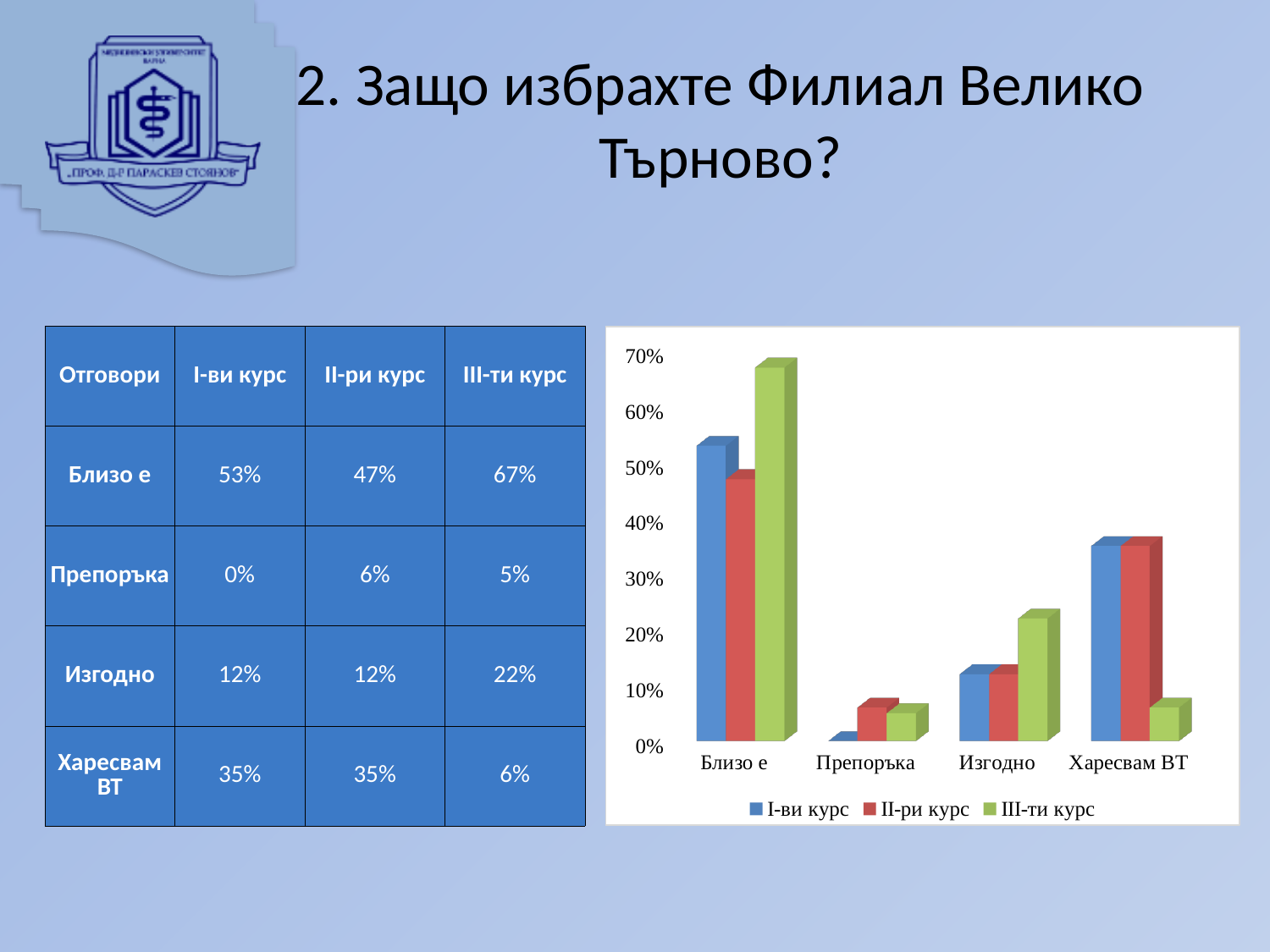
According to the slide, what is the value for III-ти курс in the category Близо е? 67% Which category has the highest value for III-ти курс? Близо е Which category has the lowest value for I-ви курс? Препоръка According to the slide, what is the value for I-ви курс in the category Харесвам ВТ? 35% How many categories are shown on the x axis of the chart? 4 According to the slide, what is the value for II-ри курс in the category Препоръка? 6% What is the difference between the III-ти курс and I-ви курс values in the category Изгодно? 10% Is the value for I-ви курс in the category Близо е greater or less than 50%? greater What kind of chart is shown on the slide? bar chart Which colour represents III-ти курс in the chart legend? green How many series does the chart legend list? 3 In the category Харесвам ВТ, which is larger: the value for II-ри курс or the value for III-ти курс? II-ри курс